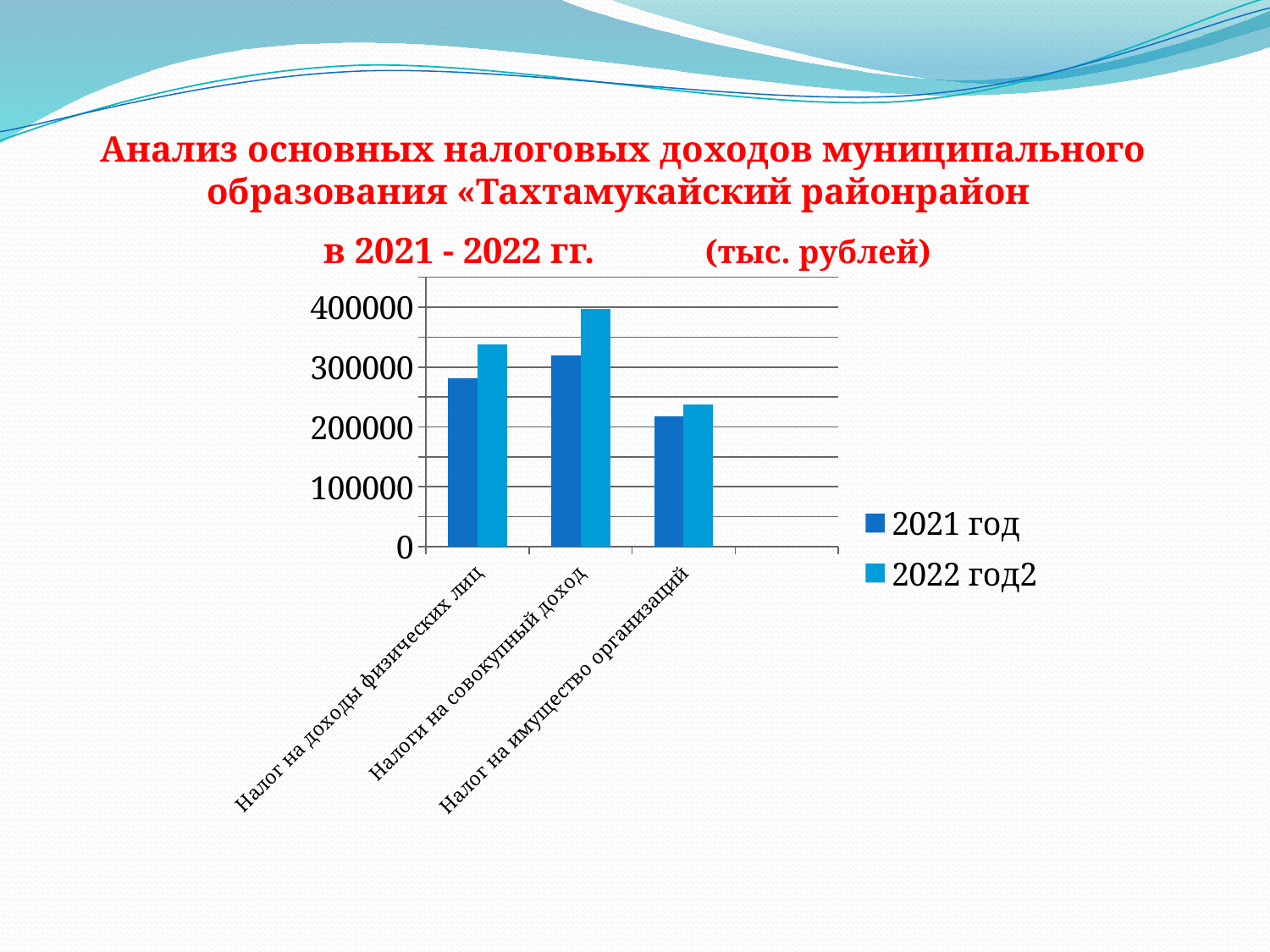
Which category has the highest value for the 2021 год series? Налоги на совокупный доход How many tax categories are shown on the x axis of the chart? 3 What unit of measurement is stated in the chart title? тыс. рублей Which category has the highest value for the 2022 год2 series? Налоги на совокупный доход What kind of chart is shown on the slide? bar chart Which category has the lowest value for the 2021 год series? Налог на имущество организаций Is the 2022 год2 value for Налоги на совокупный доход greater or less than 300000? greater For Налог на доходы физических лиц, which series has the larger value, 2021 год or 2022 год2? 2022 год2 What is the label of the second series in the legend? 2022 год2 How many series does the chart legend list? 2 Is the 2021 год value for Налог на имущество организаций greater or less than 300000? less Is the 2021 год value for Налог на доходы физических лиц greater or less than 200000? greater